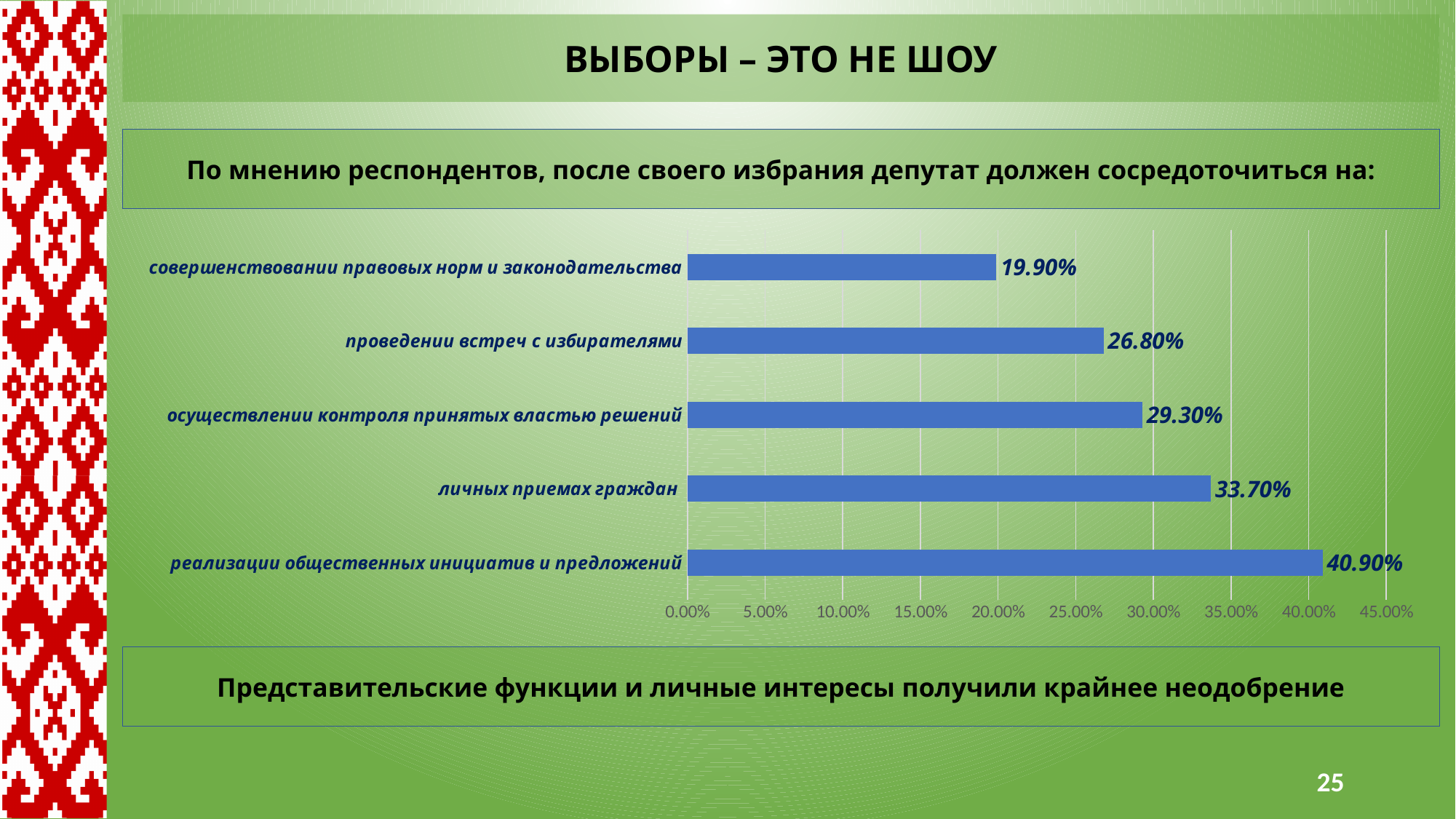
Which category has the lowest value? совершенствовании правовых норм и законодательства What value is shown for "проведении встреч с избирателями"? 26.80% Which is larger: the value for "осуществлении контроля принятых властью решений" or for "проведении встреч с избирателями"? осуществлении контроля принятых властью решений Which category has the highest value? реализации общественных инициатив и предложений What kind of chart is shown on the slide? bar chart What value is shown for "личных приемах граждан"? 33.70% How many categories are shown in the chart? 5 What is the maximum value shown on the horizontal axis? 45.00% What is the difference between the values for "реализации общественных инициатив и предложений" and "личных приемах граждан"? 7.20% What value is shown for "реализации общественных инициатив и предложений"? 40.90% What value is shown for "совершенствовании правовых норм и законодательства"? 19.90% Is the value for "осуществлении контроля принятых властью решений" greater or less than 25.00%? greater